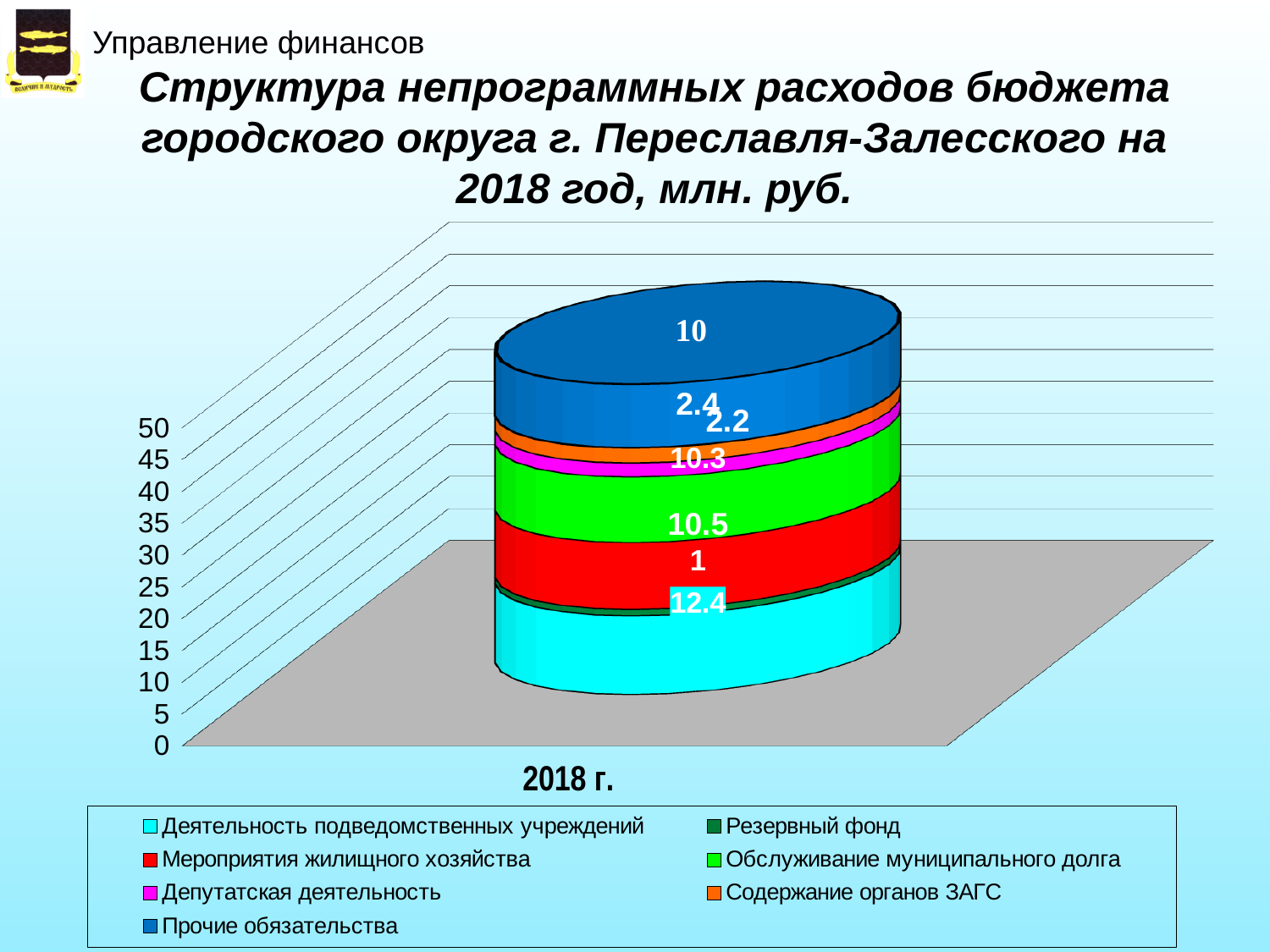
What is the total of the stacked bar for 2018 г.? 48.8 What value is shown for Резервный фонд? 1 Which is larger: Содержание органов ЗАГС or Депутатская деятельность? Содержание органов ЗАГС Which series has the smallest value in the stacked bar? Резервный фонд How many series does the legend list? 7 What value is shown for Обслуживание муниципального долга? 10.3 What is the difference between Деятельность подведомственных учреждений and Прочие обязательства? 2.4 What value is shown for Мероприятия жилищного хозяйства? 10.5 What value is shown for Деятельность подведомственных учреждений? 12.4 What kind of chart is shown on the slide? Stacked bar chart What value is shown for Прочие обязательства? 10 Which series has the largest value in the stacked bar? Деятельность подведомственных учреждений